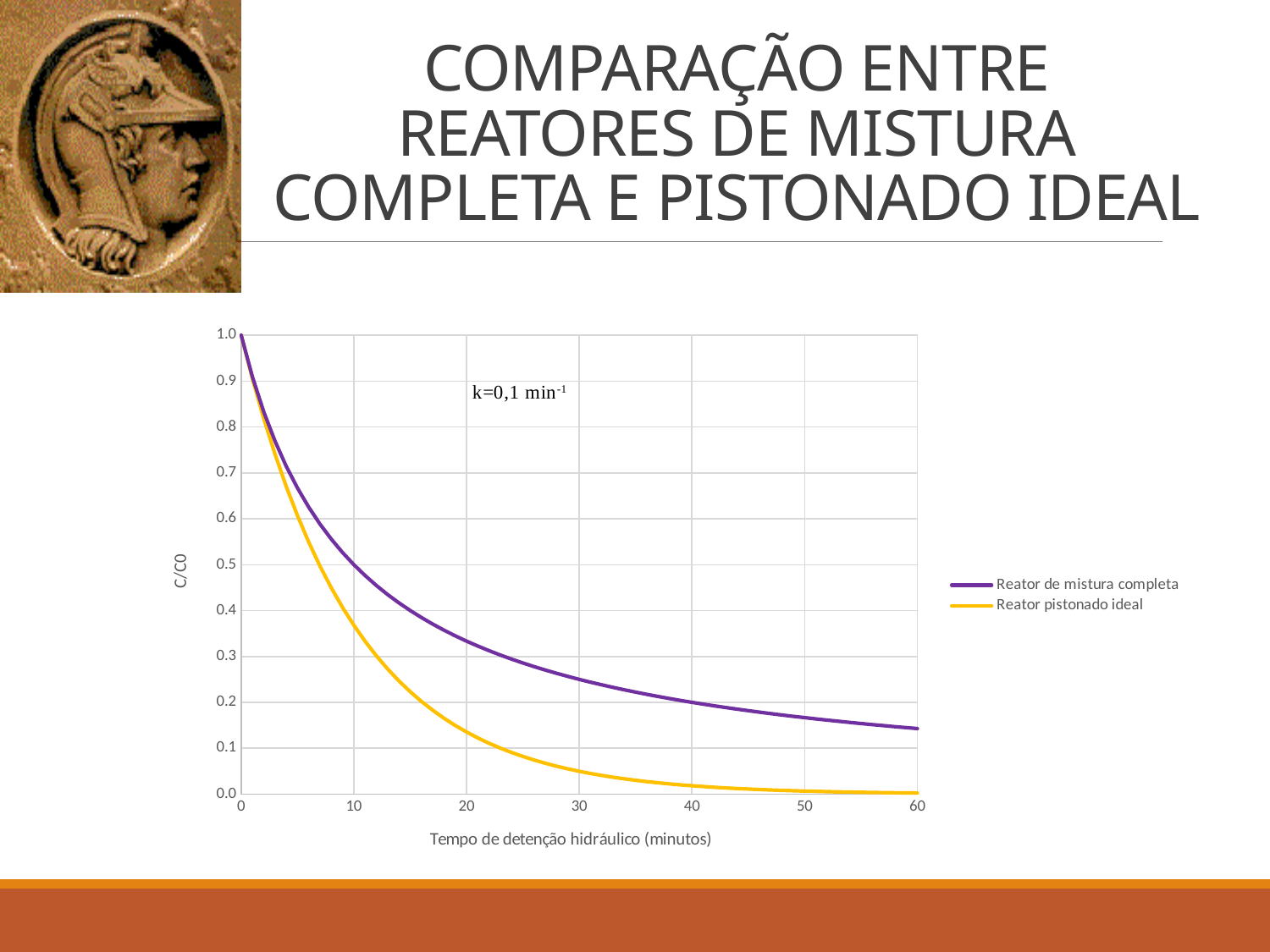
What is the label of the x axis? Tempo de detenção hidráulico (minutos) Is the value for Reator pistonado ideal at 40 minutes greater or less than 0.1? less At 30 minutes, which series has the higher C/C0 value, Reator de mistura completa or Reator pistonado ideal? Reator de mistura completa Do the C/C0 values rise or fall as the hydraulic detention time increases? fall Is the value for Reator de mistura completa at 60 minutes greater or less than 0.2? less Is the value for Reator pistonado ideal at 20 minutes greater or less than 0.2? less What kind of chart is shown on the slide? line chart What is the value of C/C0 for Reator de mistura completa at time 0? 1.0 How many series does the legend list? 2 What value of k is annotated on the chart? k=0,1 min-1 What is the value of C/C0 for Reator pistonado ideal at time 0? 1.0